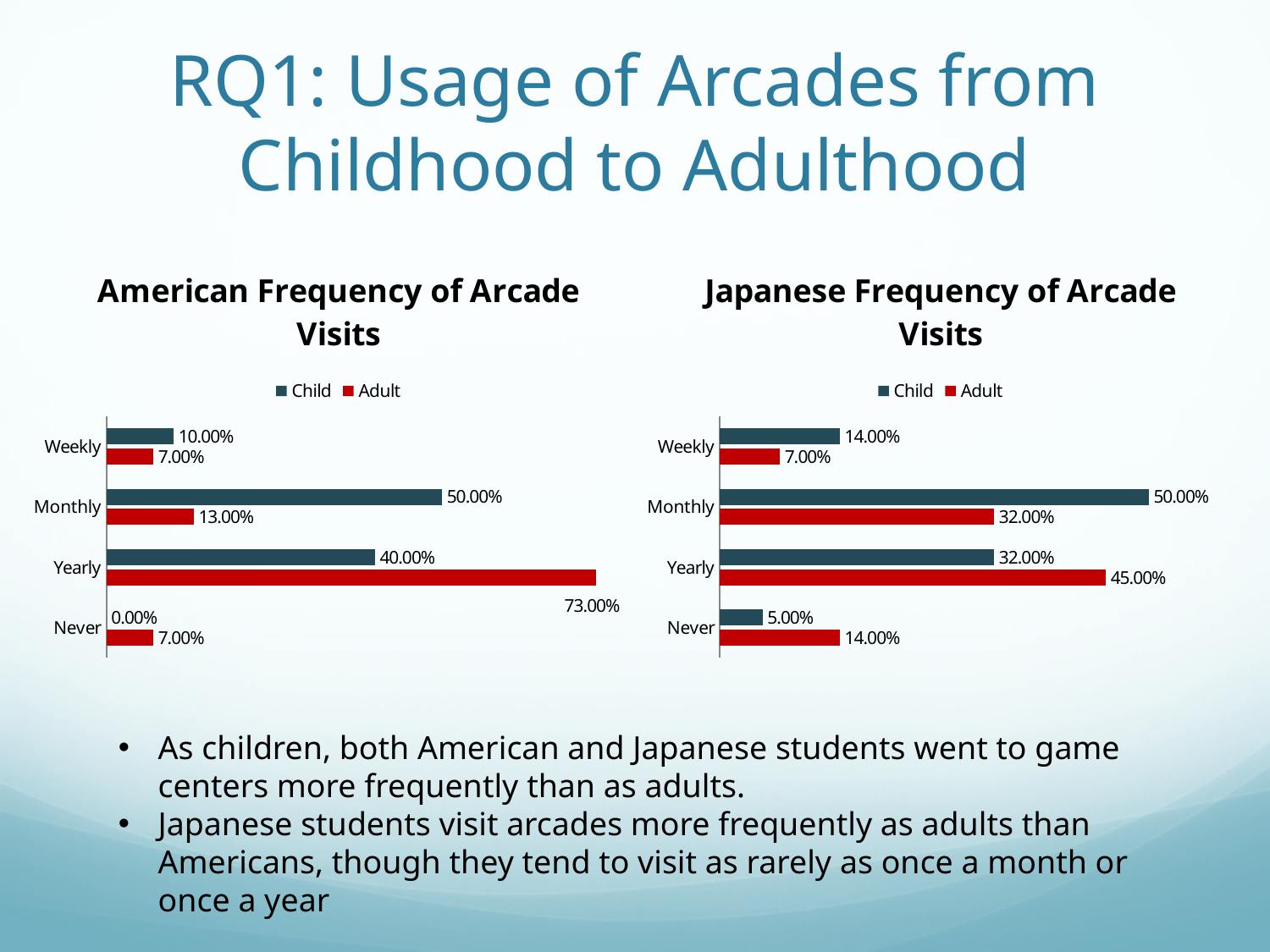
In the 'Japanese Frequency of Arcade Visits' chart, what is the Child value for Monthly? 50.00% How many series does the legend of the 'Japanese Frequency of Arcade Visits' chart list? 2 In the 'Japanese Frequency of Arcade Visits' chart, which is larger for Weekly: the Child value or the Adult value? Child In the 'American Frequency of Arcade Visits' chart, what is the Adult value for Yearly? 73.00% How many categories are shown in the 'American Frequency of Arcade Visits' chart? 4 In the 'American Frequency of Arcade Visits' chart, what is the Child value for Never? 0.00% What type of chart is the 'American Frequency of Arcade Visits' chart? Bar chart In the 'American Frequency of Arcade Visits' chart, which category has the lowest Child value? Never In the 'Japanese Frequency of Arcade Visits' chart, what colour represents the Adult series? Red In the 'Japanese Frequency of Arcade Visits' chart, which category has the highest Adult value? Yearly In the 'Japanese Frequency of Arcade Visits' chart, what is the difference between the Child and Adult values for Monthly? 18.00% In the 'American Frequency of Arcade Visits' chart, what is the difference between the Adult and Child values for Yearly? 33.00%